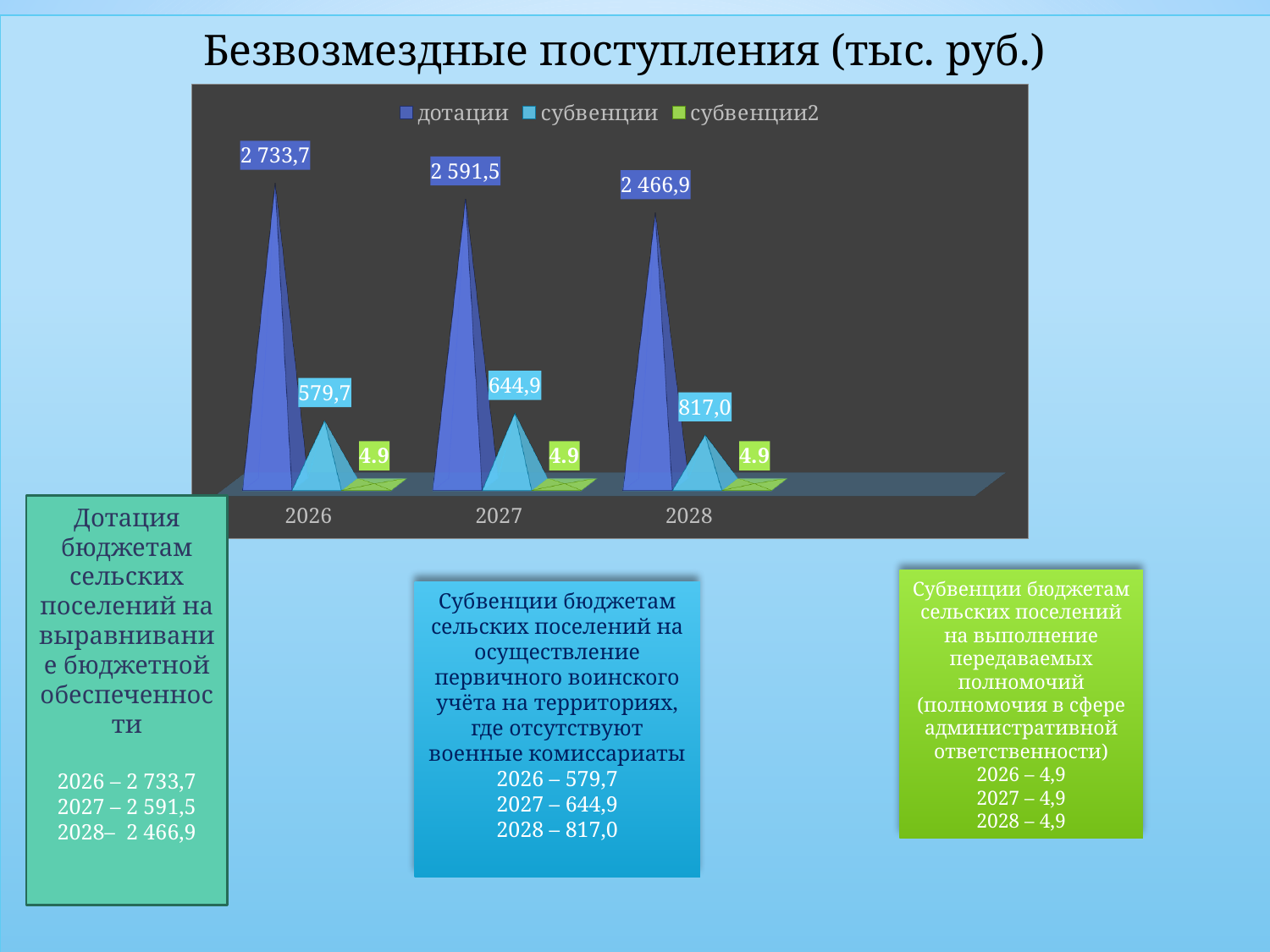
In which year is the value for дотации the highest? 2026 What is the value for дотации in 2026? 2 733,7 Which is larger: субвенции in 2027 or субвенции in 2026? субвенции in 2027 What is the difference between the дотации values for 2026 and 2028? 266,8 Do the дотации values rise or fall from 2026 to 2028? fall What is the difference between the субвенции values for 2028 and 2027? 172,1 In which year is the value for субвенции the lowest? 2026 What is the value for субвенции2 in 2027? 4,9 What is the title of the chart? Безвозмездные поступления (тыс. руб.) What is the value for субвенции in 2028? 817,0 How many years are shown on the x axis? 3 How many series does the legend list? 3